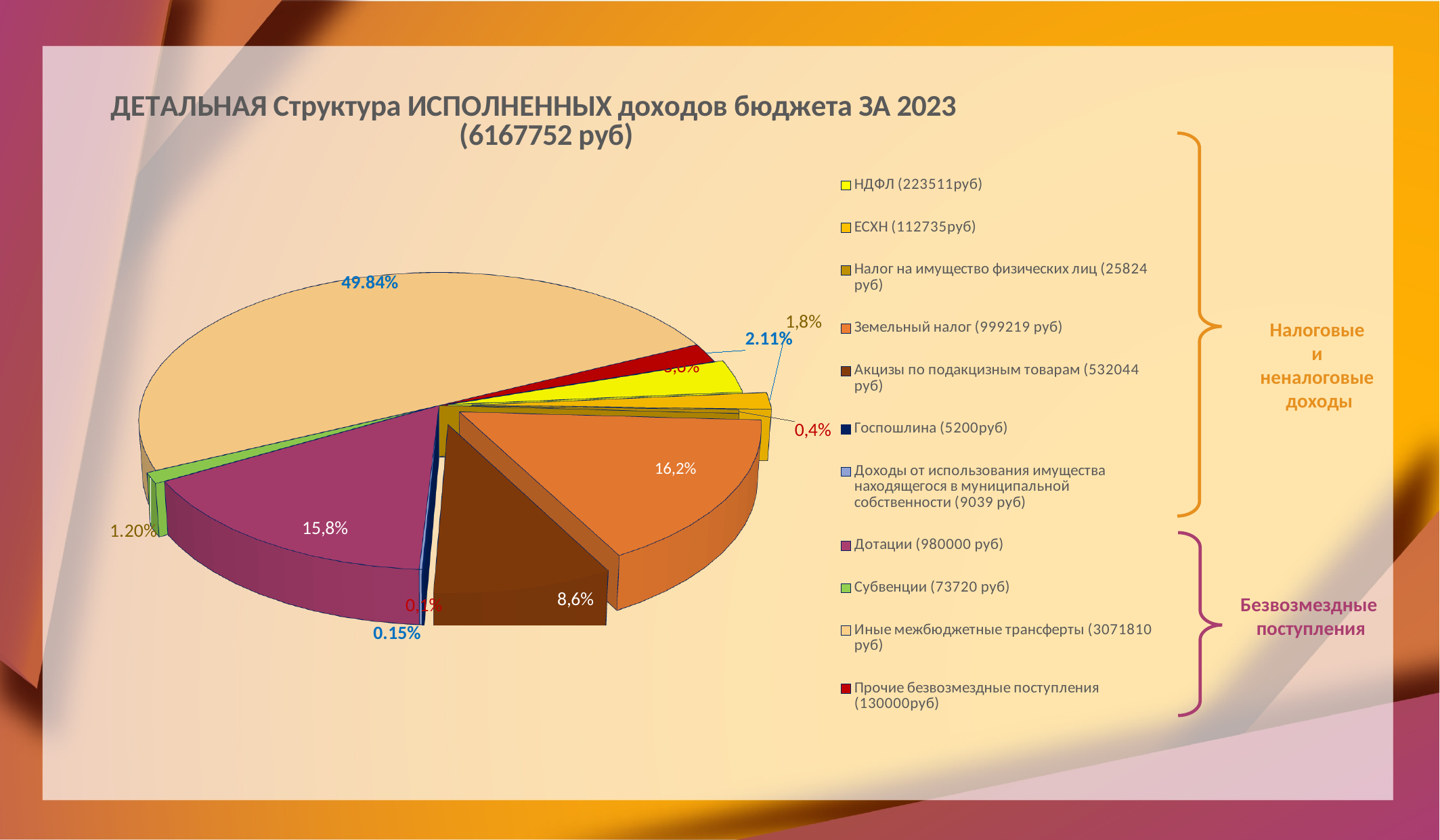
Which category has the largest share of the pie? Иные межбюджетные трансферты What share of the pie does Дотации have? 15,8% Which has the larger share of the pie, Земельный налог or Дотации? Земельный налог What share of the pie does Земельный налог have? 16,2% How many categories does the legend of the pie chart list? 11 What kind of chart is shown on the slide? Pie chart What share of the pie does Иные межбюджетные трансферты have? 49.84% What amount in rubles is shown in the legend for Дотации? 980000 руб What total amount in rubles is given in the chart title? 6167752 руб What is the difference in rubles between Земельный налог (999219 руб) and Дотации (980000 руб) as shown in the legend? 19219 руб What amount in rubles is shown in the legend for Субвенции? 73720 руб